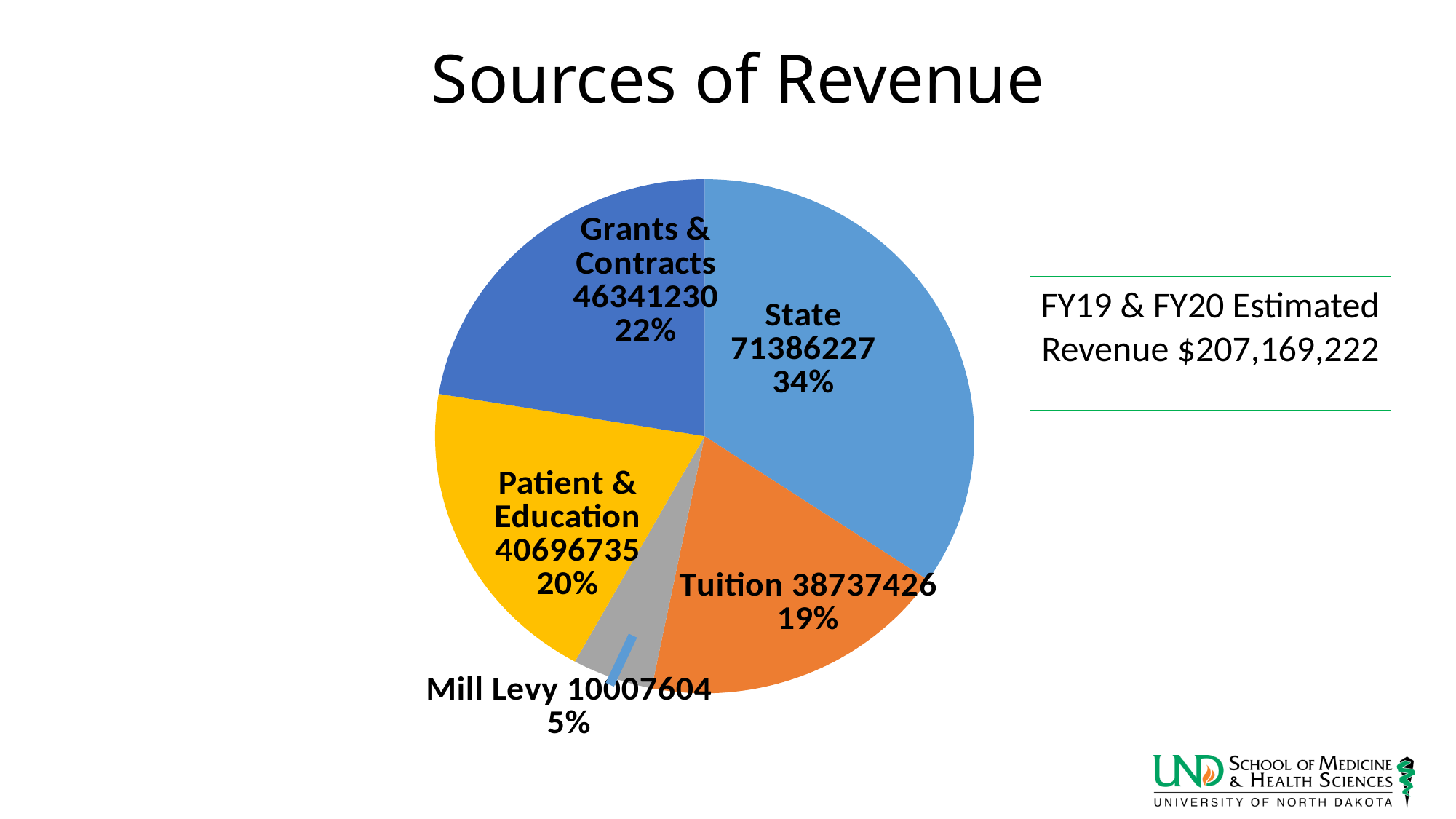
Which source of revenue is the smallest? Mill Levy How many slices does the pie chart have? 5 What percentage of revenue comes from Grants & Contracts? 22% What is the revenue value shown for State? 71386227 What is the difference between the Patient & Education value and the Tuition value? 1959309 Which source of revenue is the largest? State What share of revenue does Tuition represent? 19% What kind of chart is shown on the slide? pie chart What is the difference between the State value and the Grants & Contracts value? 25044997 What is the value shown for Mill Levy? 10007604 What is the title of the chart? Sources of Revenue Which is larger, Patient & Education or Tuition? Patient & Education